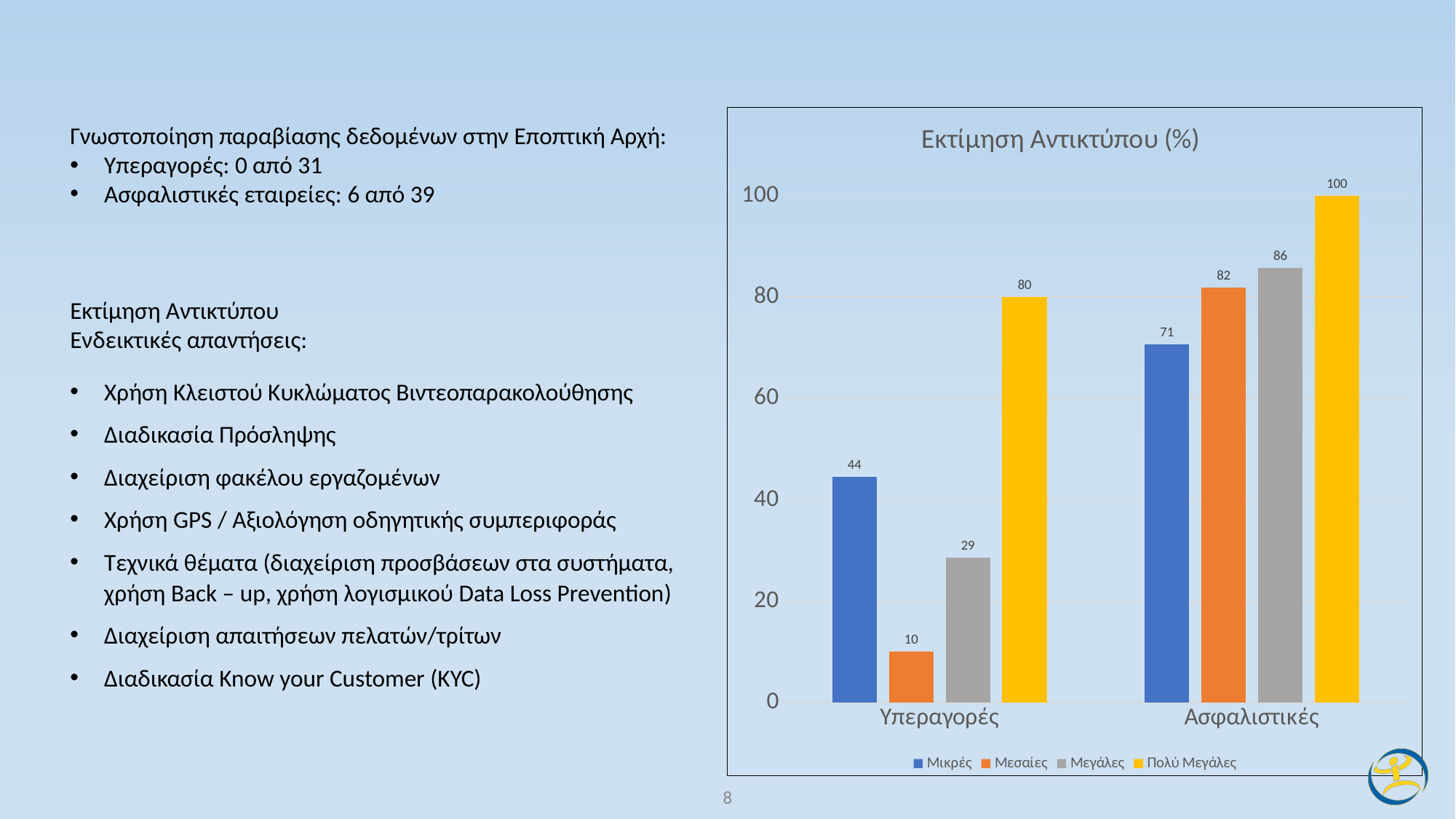
Which series has the lowest value in the Υπεραγορές category? Μεσαίες Which is larger: the Μεγάλες value for Υπεραγορές or the Μεγάλες value for Ασφαλιστικές? Ασφαλιστικές Which series has the highest value in the Ασφαλιστικές category? Πολύ Μεγάλες What kind of chart is shown on the slide? Bar chart What is the difference between the Πολύ Μεγάλες values for Ασφαλιστικές and Υπεραγορές? 20 What is the value for Πολύ Μεγάλες in the Ασφαλιστικές category? 100 What is the title of the chart? Εκτίμηση Αντικτύπου (%) How many series does the legend list? 4 How many categories are shown on the x axis? 2 Is the value for Μικρές in Ασφαλιστικές greater or less than 60? greater What is the value for Μεσαίες in the Υπεραγορές category? 10 What is the value for Μικρές in the Υπεραγορές category? 44